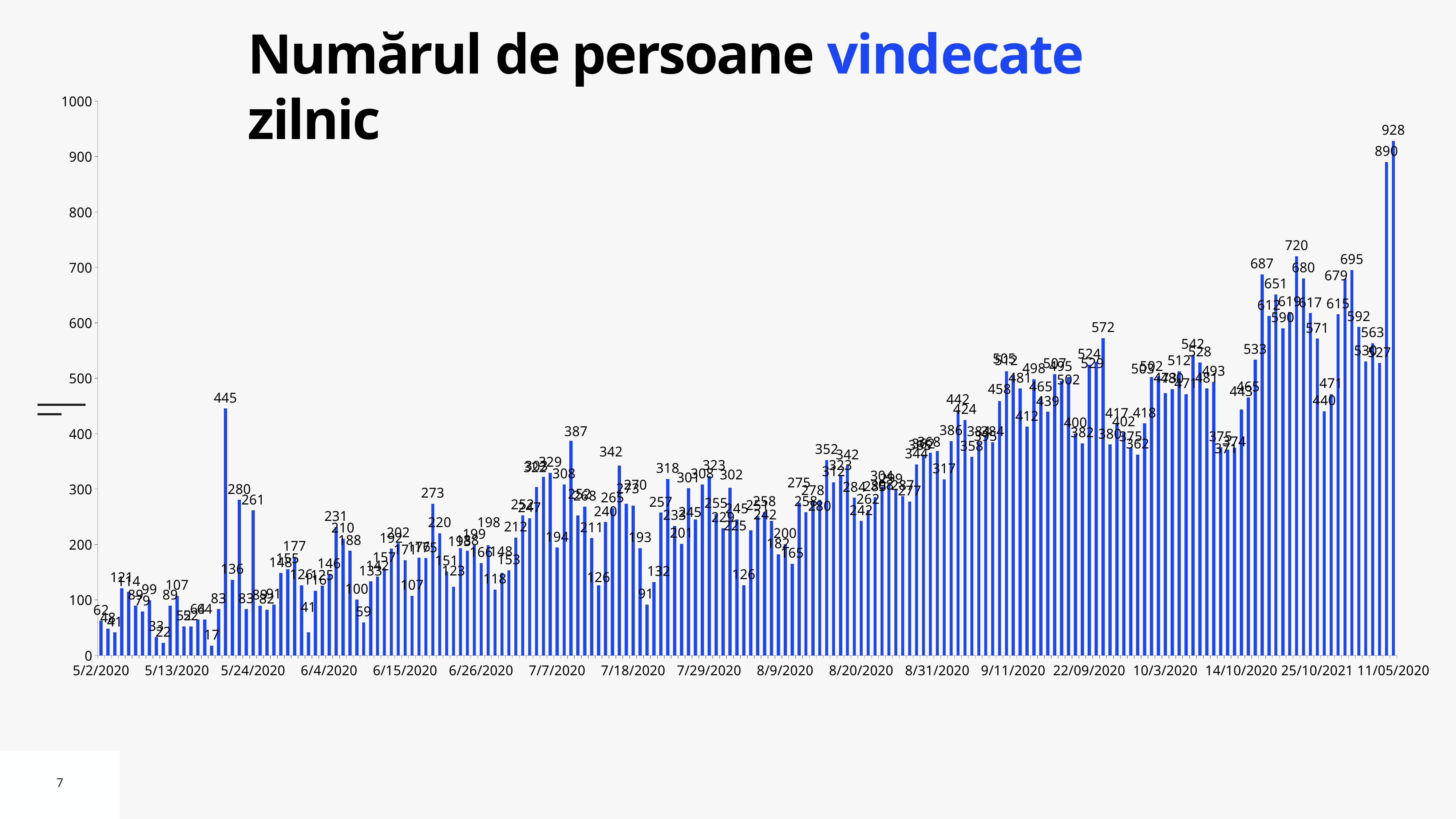
What is the lowest value shown in the chart? 17 Do the values generally rise or fall from left to right along the x axis? rise What is the difference between the two tallest bars, labelled 928 and 890? 38 What is the highest value shown in the chart? 928 What is the title of the chart? Numărul de persoane vindecate zilnic Is the value for 5/2/2020 greater or less than 100? less What kind of chart is shown on the slide? bar chart Which is larger: the bar labelled 445 in May or the bar labelled 720 in October? 720 What is the value of the first bar, at 5/2/2020? 62 What is the difference between the highest value (928) and the lowest value (17) in the chart? 911 What is the value of the last bar, at 11/05/2020? 928 Is the value for 11/05/2020 greater or less than 900? greater